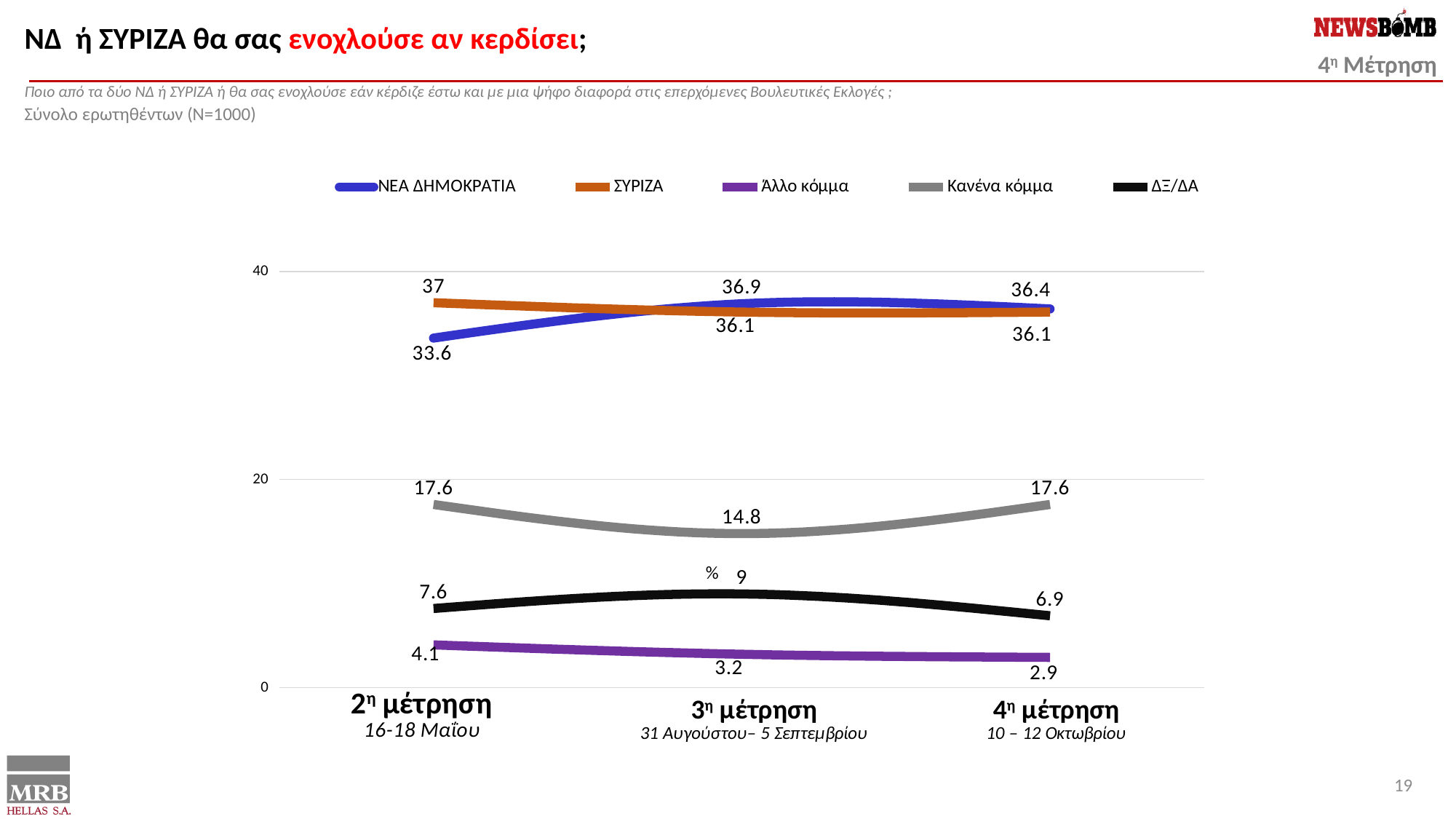
How many measurement points are shown along the x axis? 3 Which series has the highest value at the 2η μέτρηση? ΣΥΡΙΖΑ Which series has the lowest value at the 4η μέτρηση? Άλλο κόμμα What is the value for Κανένα κόμμα at the 4η μέτρηση? 17.6 What is the value for ΣΥΡΙΖΑ at the 3η μέτρηση? 36.1 What is the difference between the ΝΕΑ ΔΗΜΟΚΡΑΤΙΑ and ΣΥΡΙΖΑ values at the 2η μέτρηση? 3.4 What type of chart is shown on the slide? line chart How many series does the legend list? 5 Does the value for Άλλο κόμμα rise or fall from the 2η μέτρηση to the 4η μέτρηση? fall What is the value for ΔΞ/ΔΑ at the 3η μέτρηση? 9 Which is larger at the 3η μέτρηση: the value for Κανένα κόμμα or the value for ΔΞ/ΔΑ? Κανένα κόμμα What is the value for ΝΕΑ ΔΗΜΟΚΡΑΤΙΑ at the 2η μέτρηση? 33.6